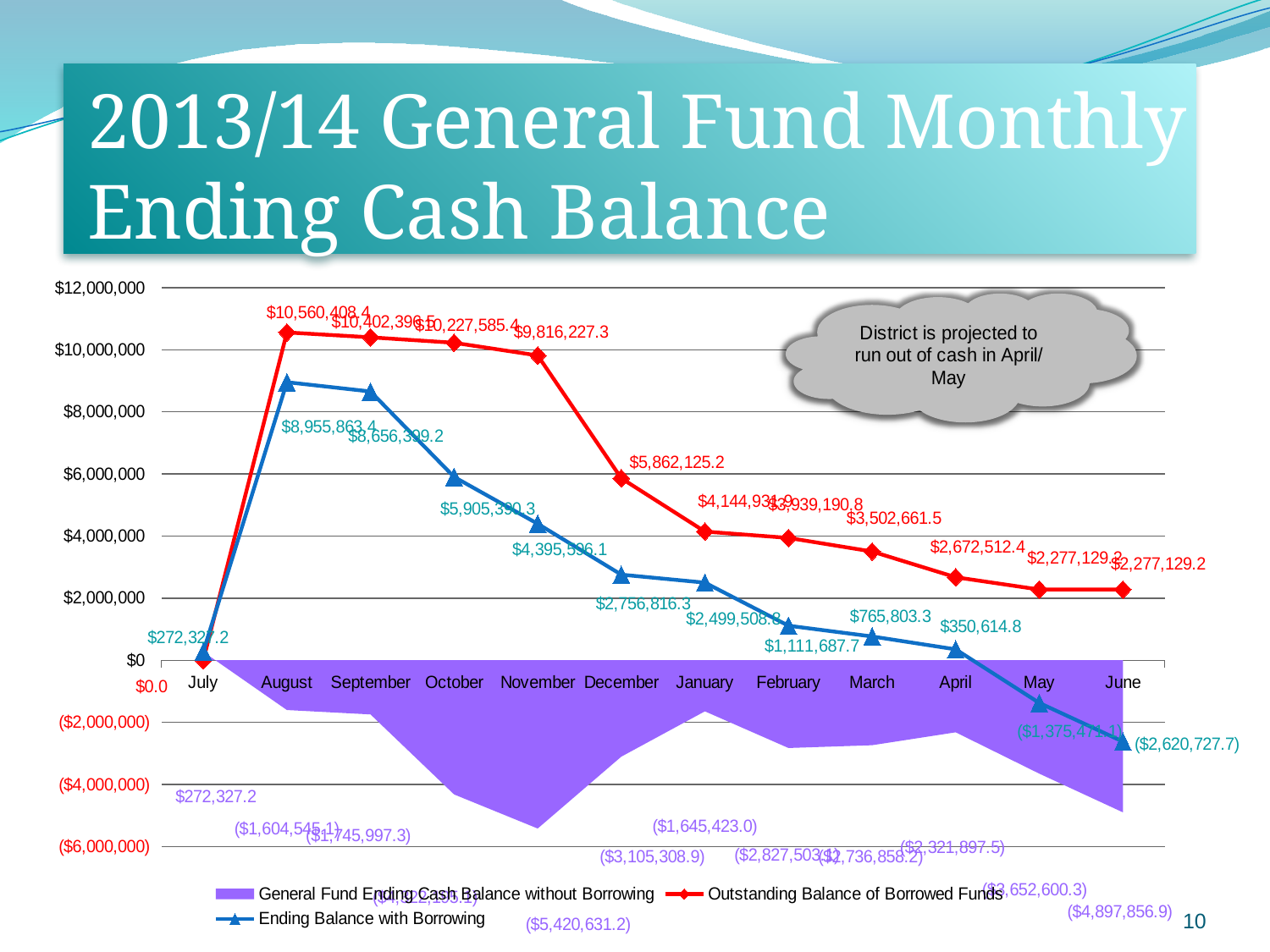
How many series does the legend list? 3 What is the Ending Balance with Borrowing in April? $350,614.8 Is the Ending Balance with Borrowing in October greater or less than $4,000,000? greater Which is larger in December: the Outstanding Balance of Borrowed Funds or the Ending Balance with Borrowing? Outstanding Balance of Borrowed Funds How many months are shown on the x axis? 12 In which month is the Ending Balance with Borrowing lowest? June In which month is the Outstanding Balance of Borrowed Funds highest? August According to the callout on the chart, when is the district projected to run out of cash? April/May What is the difference between the Outstanding Balance of Borrowed Funds in November and in December? $3,954,102.1 What is the General Fund Ending Cash Balance without Borrowing in November? ($5,420,631.2) Does the Outstanding Balance of Borrowed Funds rise or fall from December to June? fall What is the Outstanding Balance of Borrowed Funds in August? $10,560,408.4